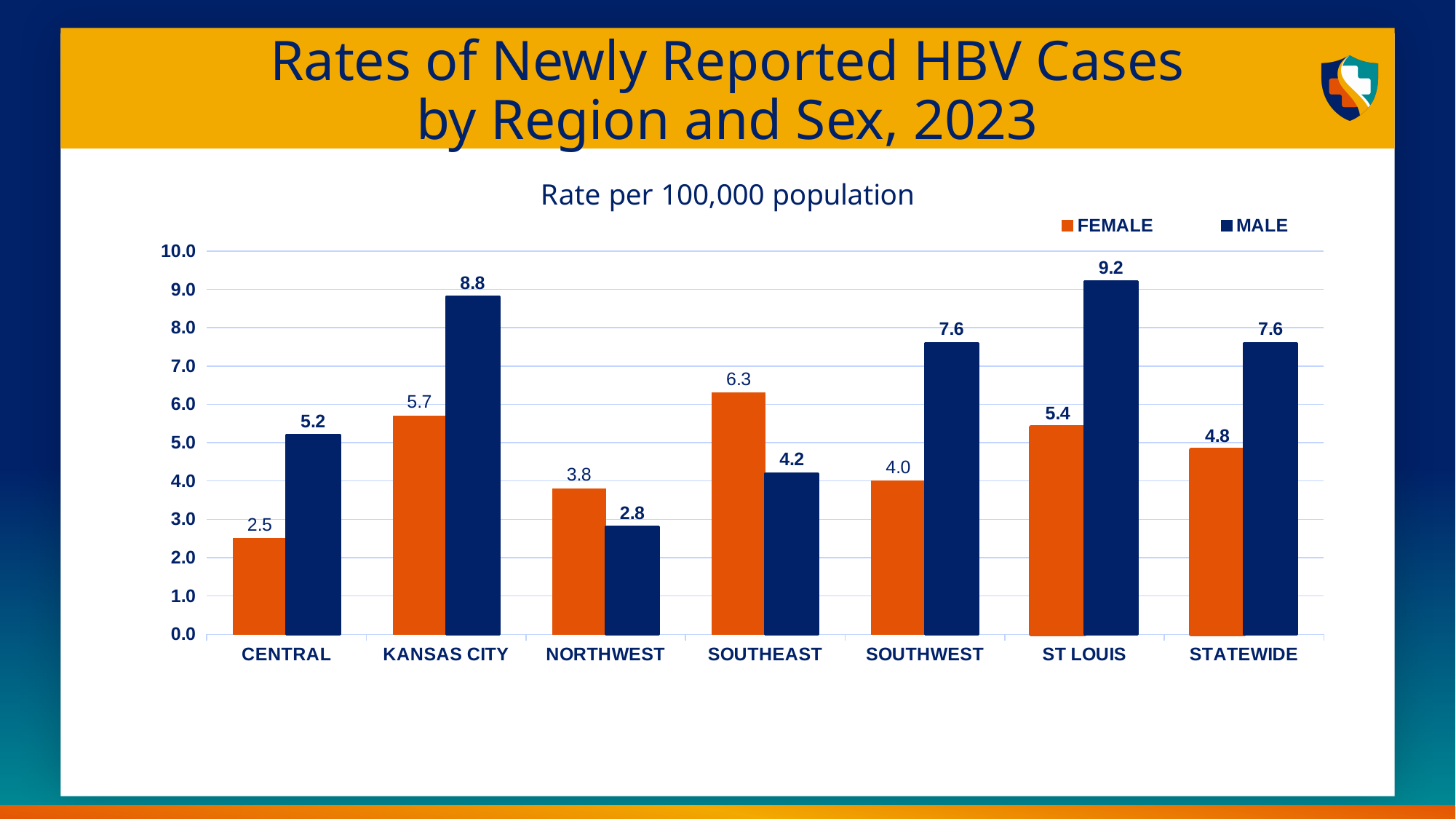
Which region has the highest male rate of newly reported HBV cases? St Louis Which region has the lowest female rate of newly reported HBV cases? Central What is the female rate of newly reported HBV cases in the Southeast region? 6.3 What unit is the rate expressed in, according to the chart subtitle? Rate per 100,000 population How many series does the legend list? 2 Is the male rate for St Louis greater or less than 9.0? greater What is the difference between the male and female rates in Kansas City? 3.1 Which is larger in the Northwest region, the female rate or the male rate? Female How many regions (categories) are shown on the x axis? 7 What is the statewide male rate per 100,000 population? 7.6 What kind of chart is shown on the slide? Bar chart What is the male rate of newly reported HBV cases in Kansas City? 8.8